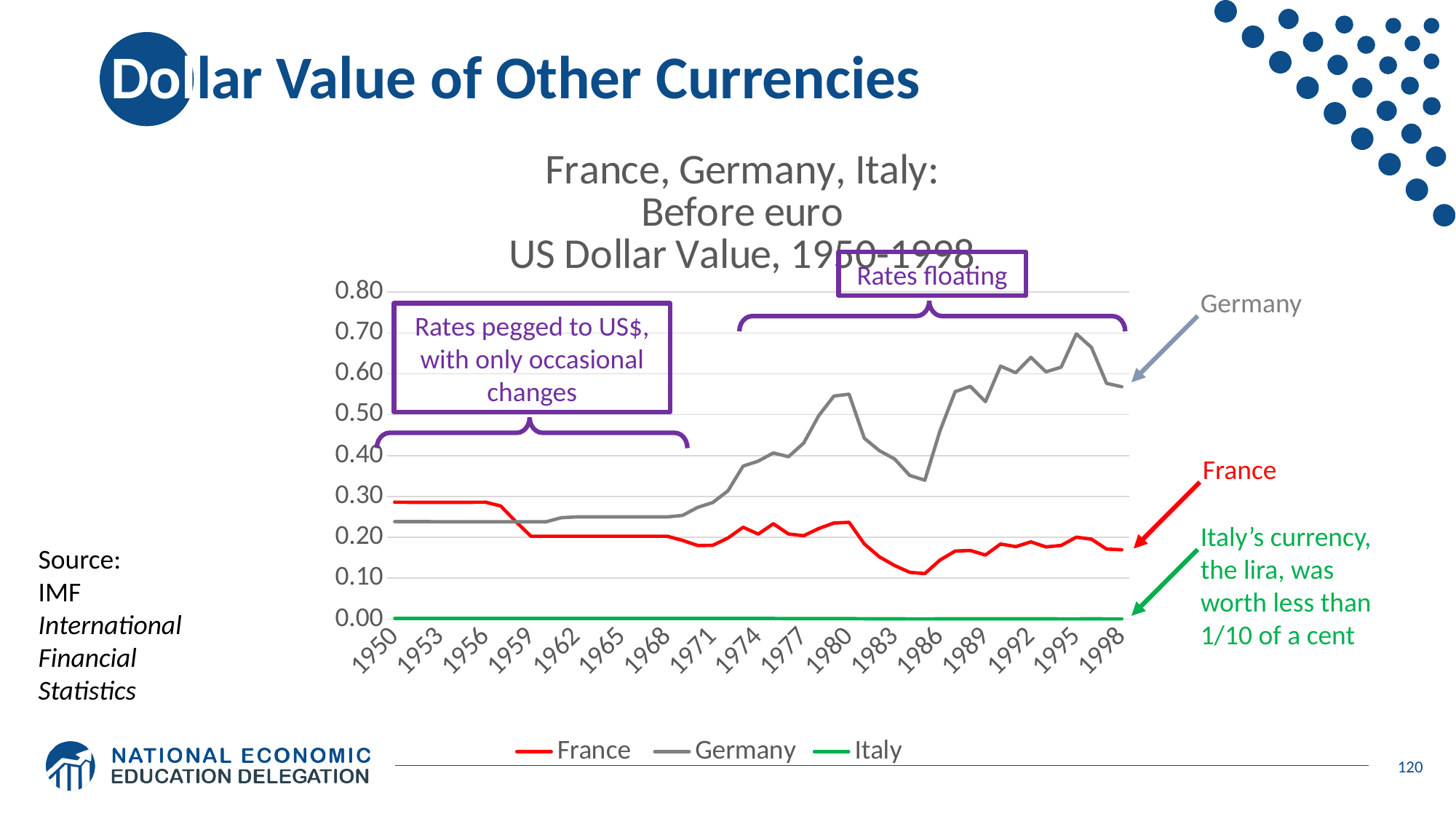
Is the value for Italy in 1998 greater or less than 0.10? less Which series has the highest value in 1998? Germany How many series does the chart legend list? 3 Which series has the lowest value across the whole chart? Italy Does the Germany line rise or fall overall from 1950 to 1998? Rises In 1998, which is larger, the value for France or the value for Germany? Germany Is the value for France in 1950 greater or less than 0.20? greater What kind of chart is shown on the slide? Line chart Does the France line rise or fall overall from 1950 to 1998? Falls Is the value for Germany in 1995 greater or less than 0.60? greater Which currencies are listed in the chart legend? France, Germany, Italy